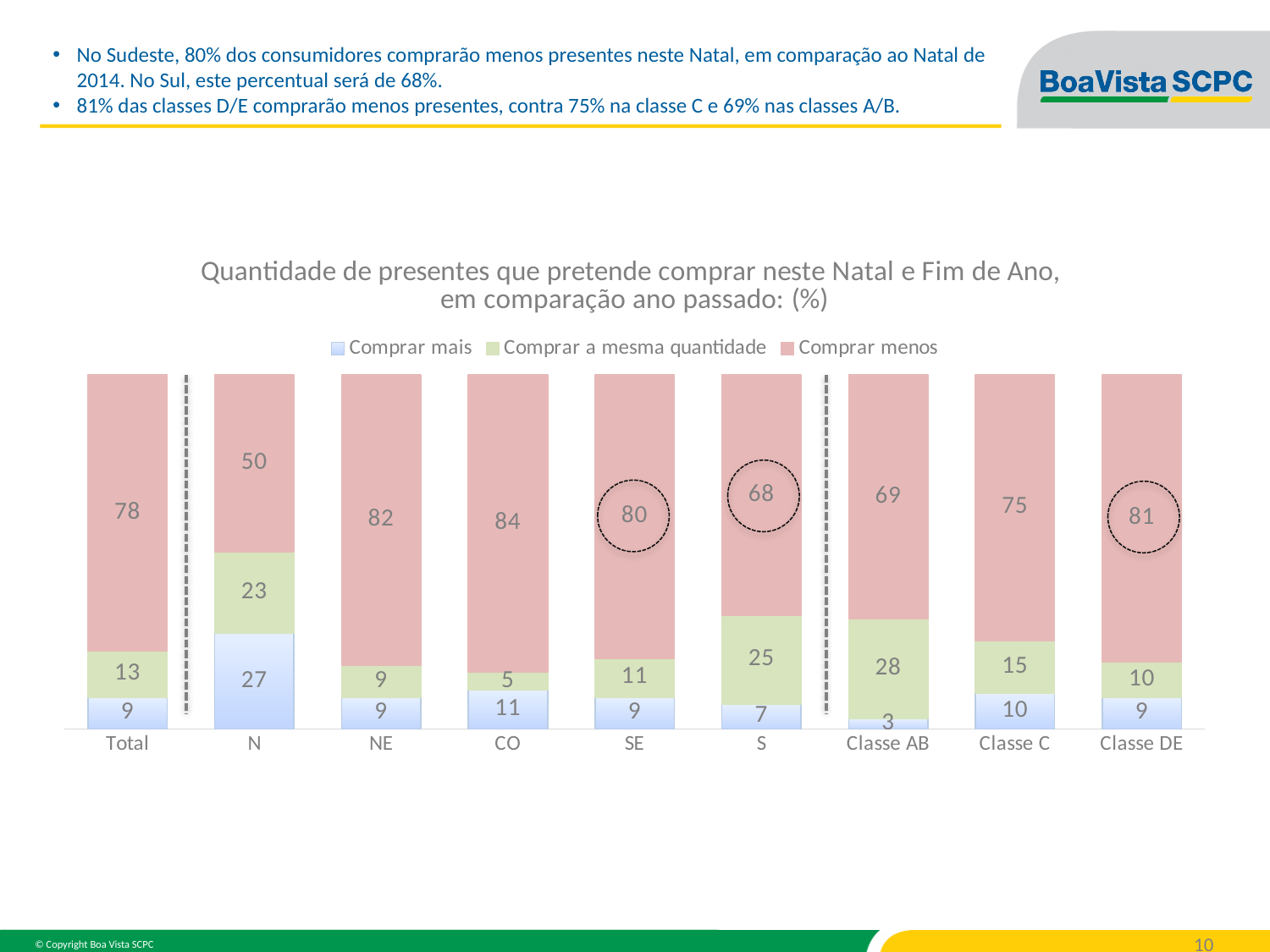
Which is larger: the "Comprar a mesma quantidade" value for S or for Classe C? S What is the value of "Comprar mais" for N? 27 How many series does the legend list? 3 What kind of chart is shown on the slide? Stacked bar chart What is the value of "Comprar a mesma quantidade" for Classe AB? 28 How many categories are shown on the x axis? 9 What is the value of "Comprar menos" for CO? 84 Which category has the lowest value for "Comprar mais"? Classe AB What is the difference between the "Comprar menos" values for Classe DE and Classe AB? 12 Which category has the highest value for "Comprar menos"? CO Which legend entry is shown in red/pink? Comprar menos What is the total of the stacked bar for SE? 100